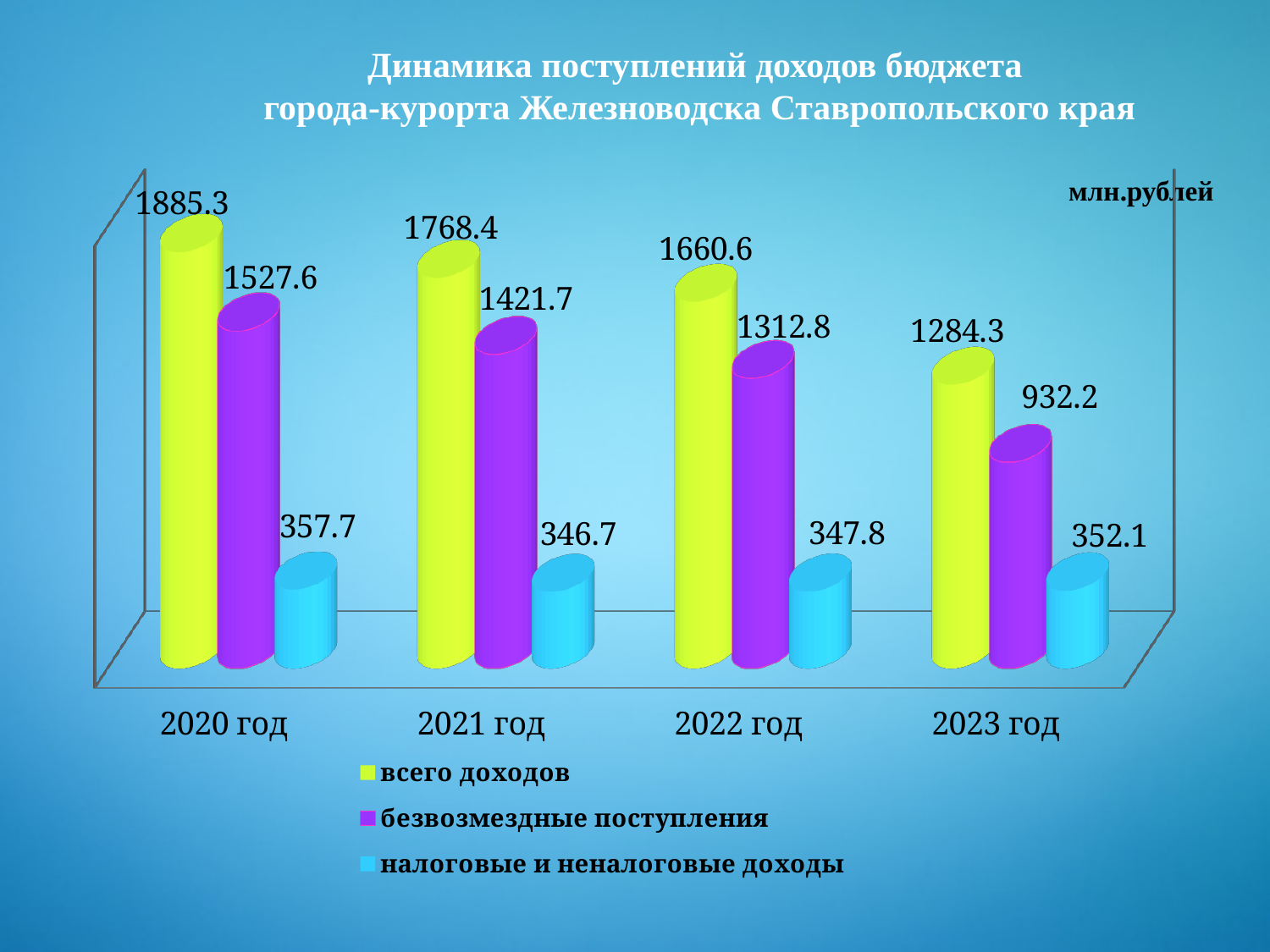
What is the value of "всего доходов" for 2020 год? 1885.3 What is the difference between "всего доходов" in 2020 год and 2023 год? 601.0 What is the value of "налоговые и неналоговые доходы" for 2023 год? 352.1 Does "всего доходов" rise or fall from 2020 год to 2023 год? Fall Which is larger: "налоговые и неналоговые доходы" in 2020 год or in 2021 год? 2020 год How many series does the legend list? 3 What is the value of "безвозмездные поступления" for 2022 год? 1312.8 In which year is "безвозмездные поступления" the lowest? 2023 год What kind of chart is shown on the slide? Bar chart What is the value of "безвозмездные поступления" for 2021 год? 1421.7 How many years are shown on the x axis? 4 In which year is "всего доходов" the highest? 2020 год